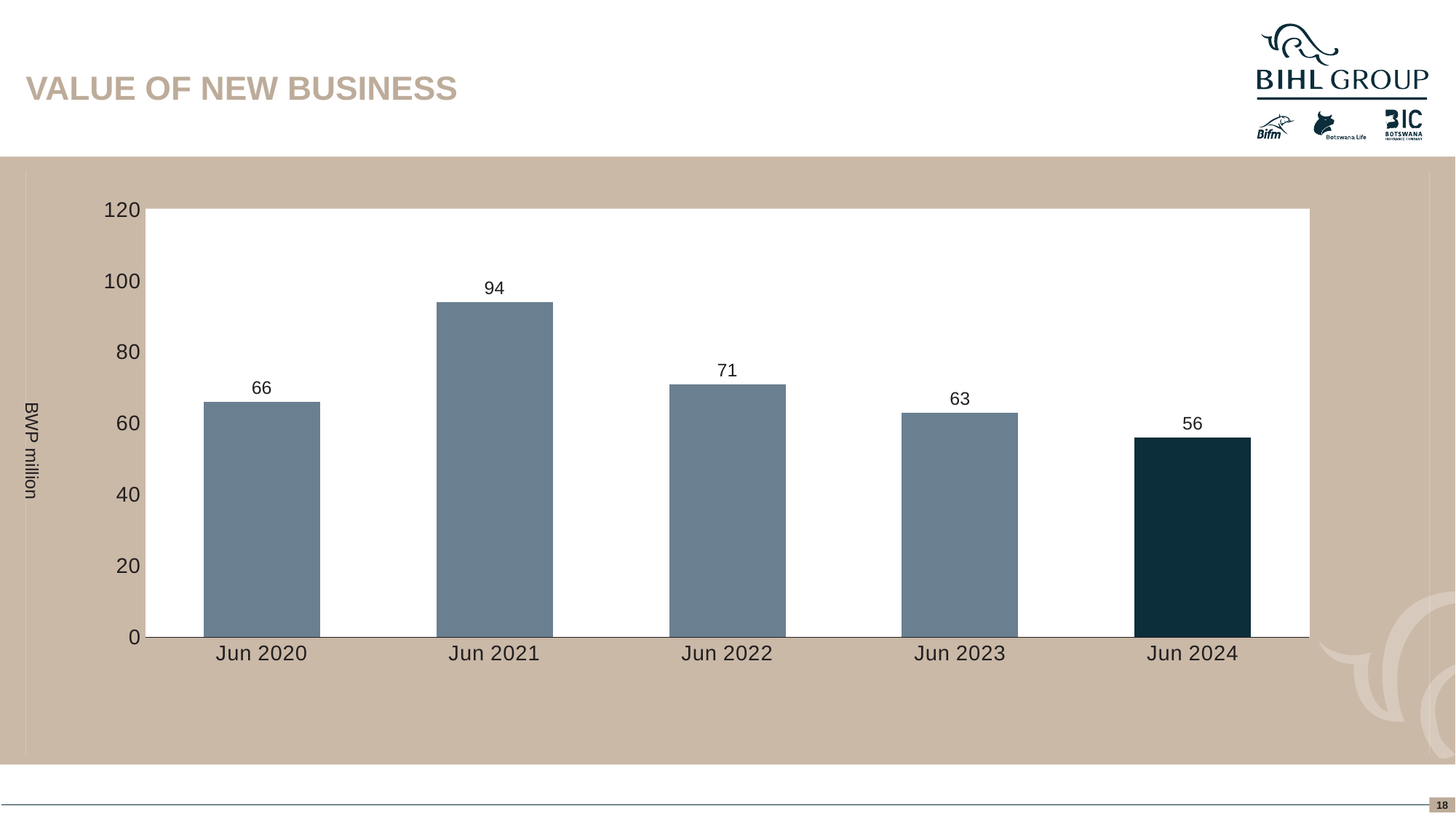
What is the difference between the values for Jun 2021 and Jun 2024? 38 Which period has the lowest value of new business? Jun 2024 What is the value of new business for Jun 2021? 94 Which period has the highest value of new business? Jun 2021 What is the value of new business for Jun 2024? 56 What unit is shown on the vertical axis label? BWP million Which is larger, the value for Jun 2020 or Jun 2022? Jun 2022 What is the value of new business for Jun 2020? 66 What is the difference between the values for Jun 2022 and Jun 2023? 8 How many periods are shown on the chart? 5 What kind of chart is shown on the slide? Bar chart Do the values rise or fall from Jun 2021 to Jun 2024? Fall